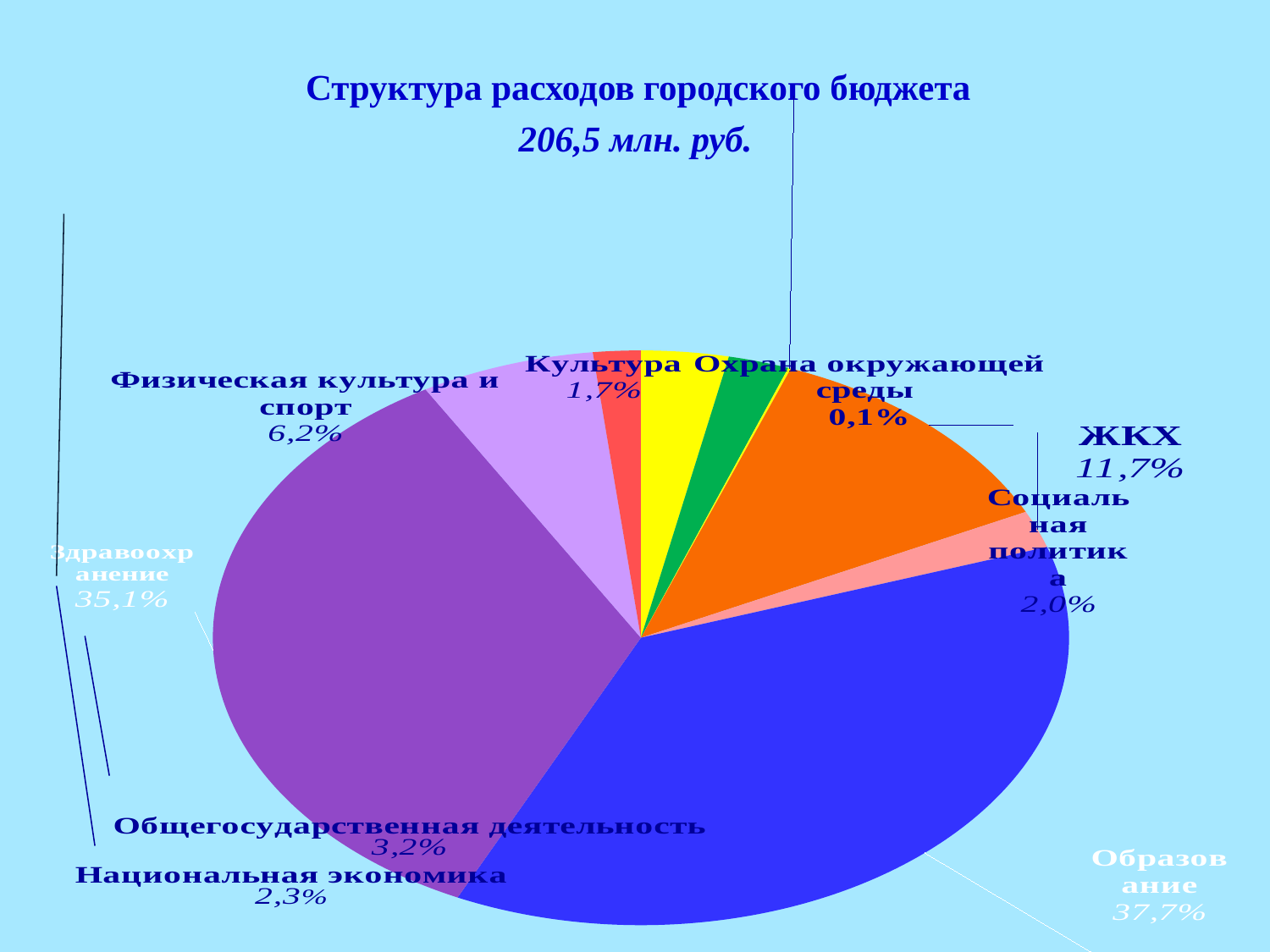
Which category has the largest share of the city budget expenditure? Образование What share of the city budget expenditure goes to Здравоохранение? 35,1% What is the difference in percentage points between the shares of Образование and Здравоохранение? 2,6 How many categories are shown in the pie chart? 9 What total amount of expenditure is stated in the chart title? 206,5 млн. руб. What share of the city budget expenditure goes to ЖКХ? 11,7% What share of the city budget expenditure goes to Охрана окружающей среды? 0,1% Which category has the smallest share of the city budget expenditure? Охрана окружающей среды What share of the city budget expenditure goes to Физическая культура и спорт? 6,2% What kind of chart is shown on the slide? pie chart Which has a larger share: ЖКХ or Физическая культура и спорт? ЖКХ What share of the city budget expenditure goes to Образование? 37,7%